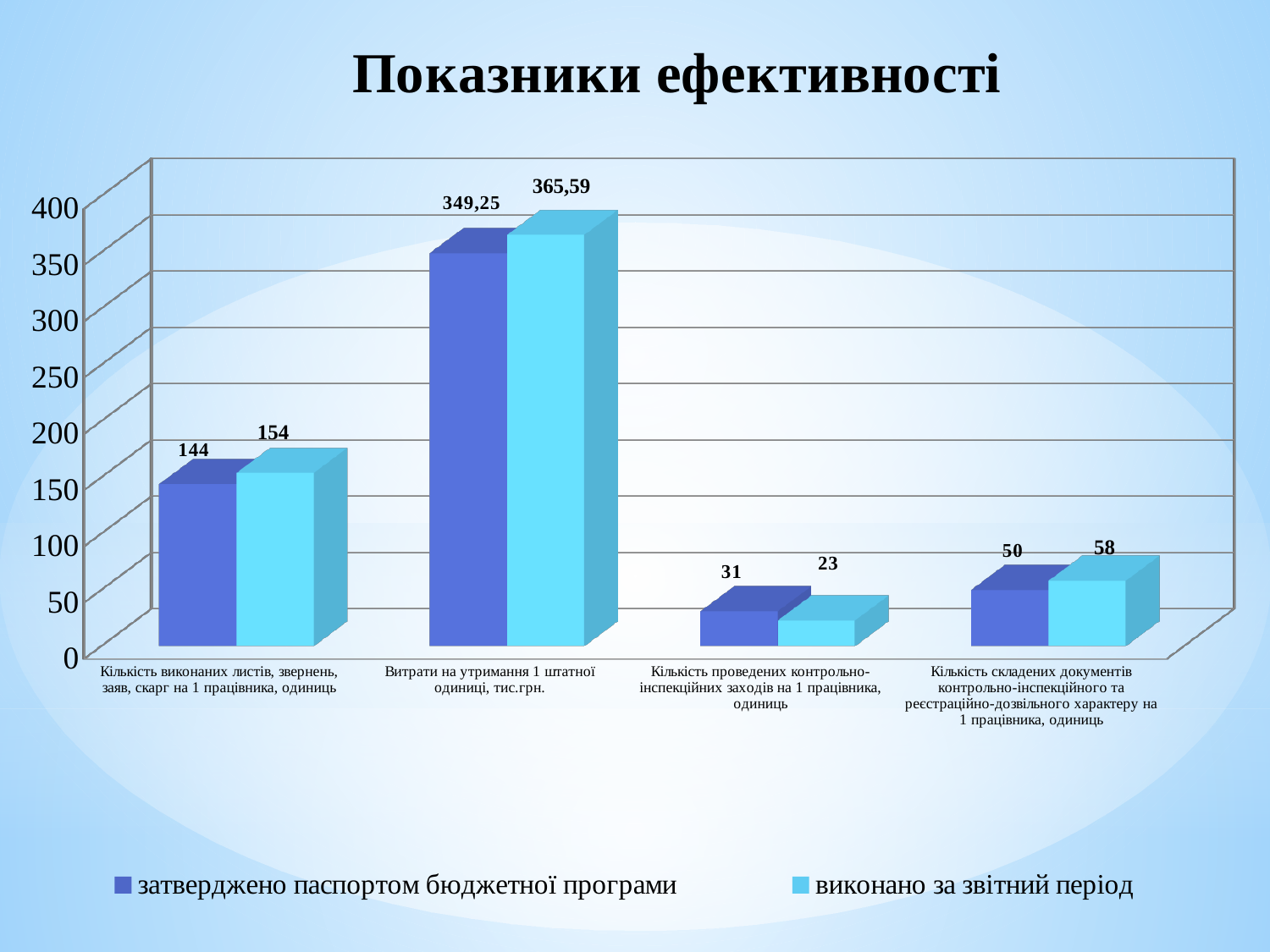
How many categories are shown on the x axis of the chart? 4 What is the value for "затверджено паспортом бюджетної програми" in the category "Витрати на утримання 1 штатної одиниці, тис.грн."? 349,25 What is the title of the chart on the slide? Показники ефективності In the category "Кількість проведених контрольно-інспекційних заходів на 1 працівника, одиниць", which series has the larger value? затверджено паспортом бюджетної програми What is the value for "виконано за звітний період" in the category "Кількість виконаних листів, звернень, заяв, скарг на 1 працівника, одиниць"? 154 Which category has the lowest value for "затверджено паспортом бюджетної програми"? Кількість проведених контрольно-інспекційних заходів на 1 працівника, одиниць What is the value for "виконано за звітний період" in the category "Кількість проведених контрольно-інспекційних заходів на 1 працівника, одиниць"? 23 Is the value for "виконано за звітний період" in the category "Витрати на утримання 1 штатної одиниці, тис.грн." greater or less than 350? greater How many series does the legend list? 2 What kind of chart is shown on the slide? bar chart Which category has the highest value for "виконано за звітний період"? Витрати на утримання 1 штатної одиниці, тис.грн. What is the difference between the "виконано за звітний період" and "затверджено паспортом бюджетної програми" values in the category "Кількість виконаних листів, звернень, заяв, скарг на 1 працівника, одиниць"? 10